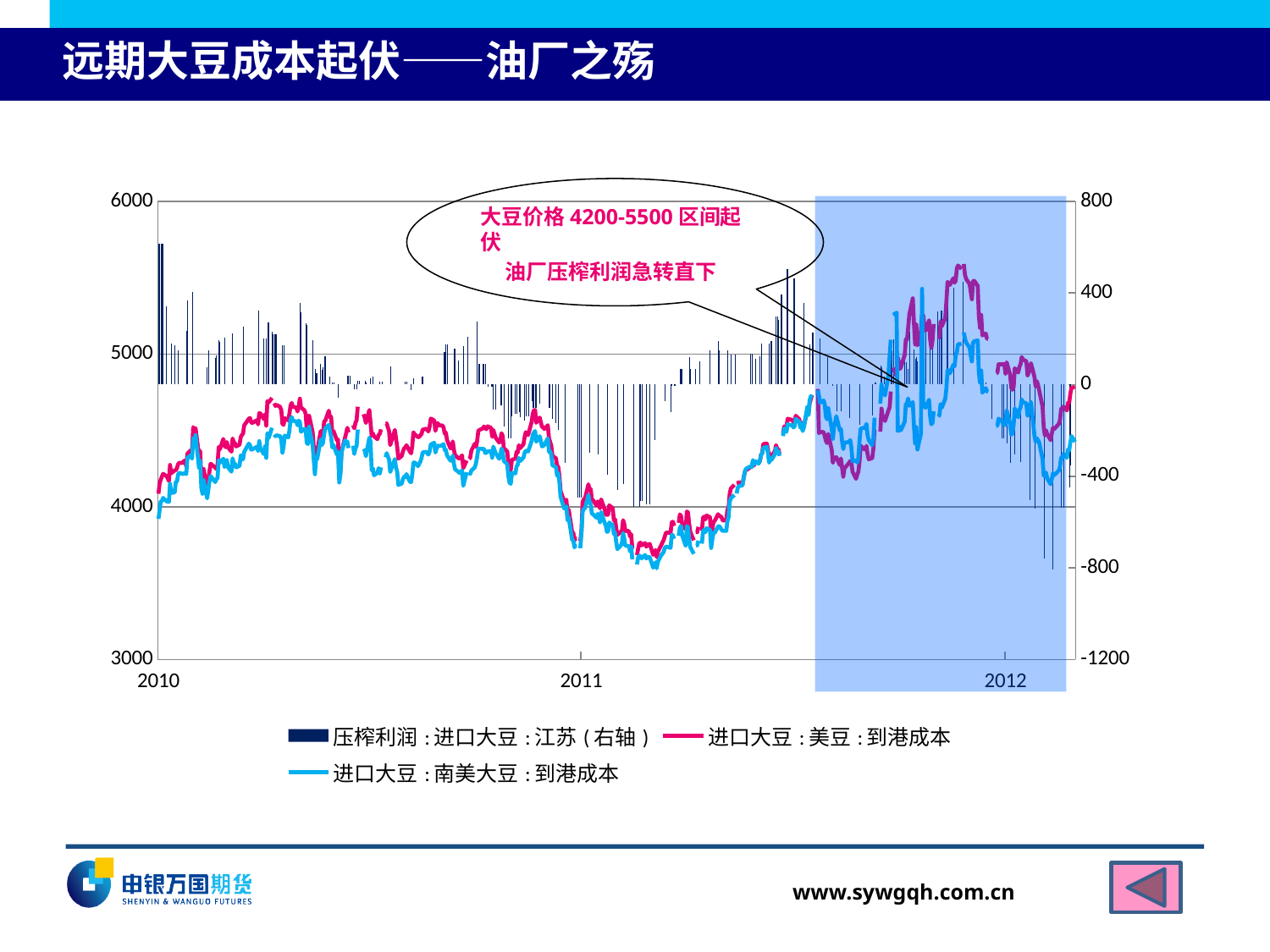
What is the title of the slide containing the chart? 远期大豆成本起伏——油厂之殇 Which line is higher at the start of 2012, 进口大豆：美豆：到港成本 or 进口大豆：南美大豆：到港成本? 进口大豆：美豆：到港成本 Do the cost lines rise or fall from mid-2011 to early 2012? rise How many series does the chart legend list? 3 Which series is plotted on the right axis according to the legend? 压榨利润：进口大豆：江苏（右轴） What kind of chart is shown on the slide? Combination chart of bars and lines Is the value of 进口大豆：美豆：到港成本 at the start of 2010 greater or less than 5000? less Is the first 压榨利润 bar at the start of 2010 greater or less than 400 on the right axis? greater How many year labels are shown on the x axis? 3 Is the lowest value of 进口大豆：南美大豆：到港成本 in 2011 greater or less than 4000? less